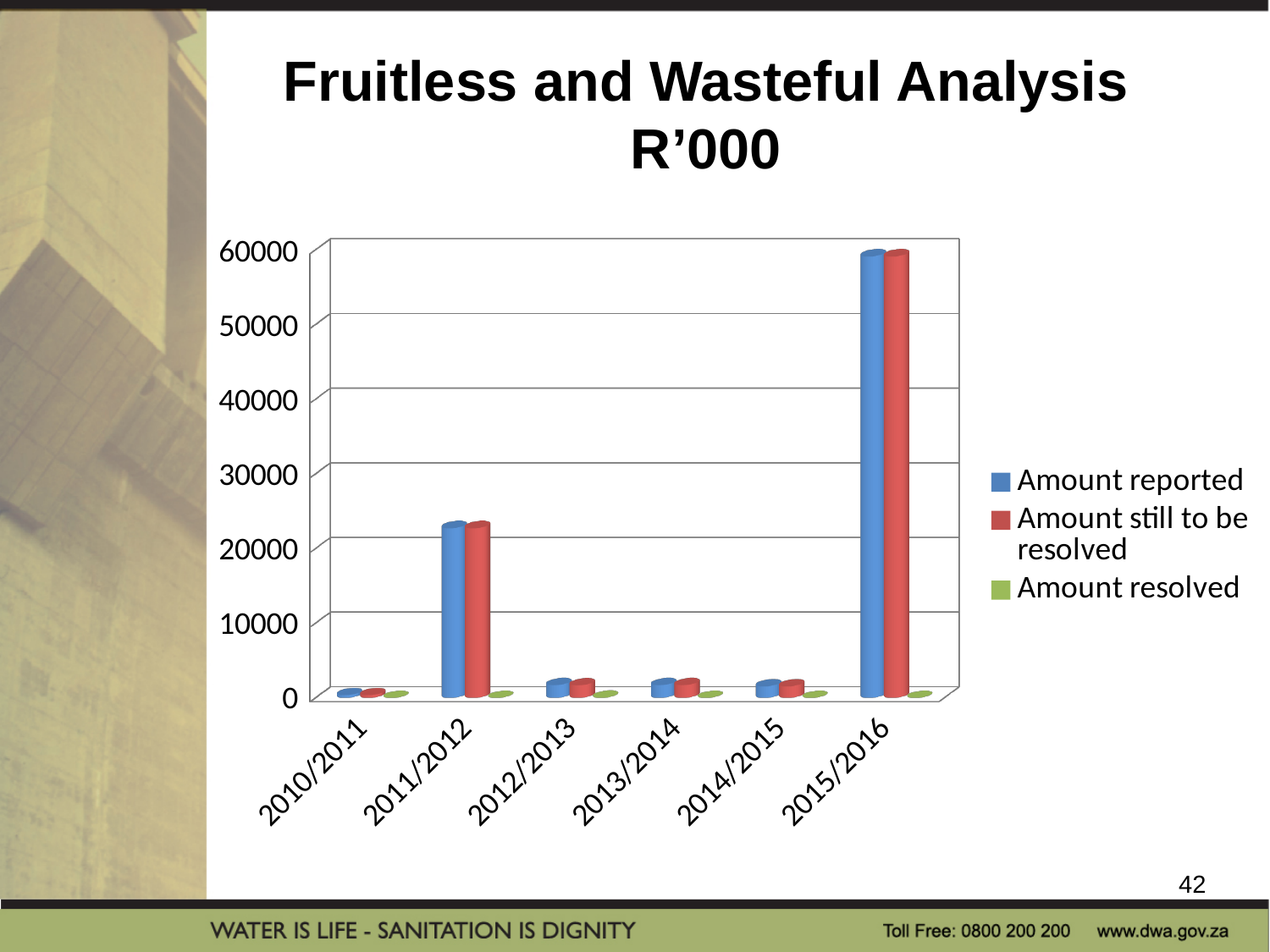
How many financial years are shown on the x axis? 6 How many series does the legend list? 3 Which year has the lowest Amount reported? 2010/2011 What is the title of the chart? Fruitless and Wasteful Analysis R'000 Which colour represents the Amount resolved series? green What kind of chart is shown on the slide? bar chart Is the Amount still to be resolved for 2012/2013 greater or less than 10000? less Is the Amount reported for 2011/2012 greater or less than 20000? greater Which is larger, the Amount reported for 2015/2016 or for 2011/2012? 2015/2016 Is the Amount resolved for 2015/2016 greater or less than 10000? less Which year has the highest Amount reported? 2015/2016